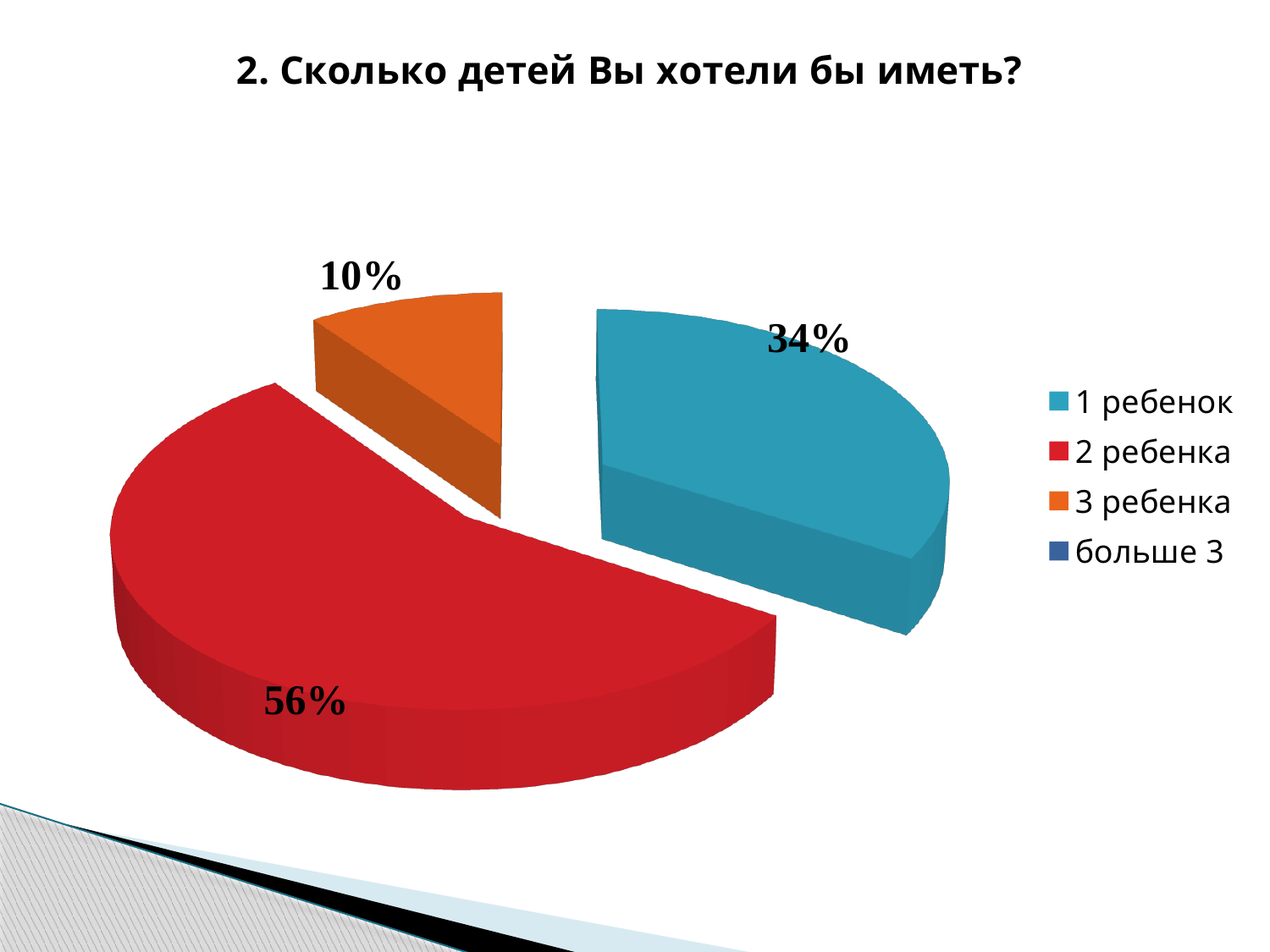
What share of the pie corresponds to "2 ребенка"? 56% What share of the pie corresponds to "3 ребенка"? 10% What kind of chart is shown on the slide? pie chart What colour is the slice for "2 ребенка"? red Which is larger: the slice for "1 ребенок" or the slice for "3 ребенка"? 1 ребенок What is the title of the chart? 2. Сколько детей Вы хотели бы иметь? What is the difference between the share for "1 ребенок" and the share for "3 ребенка"? 24% What is the difference between the share for "2 ребенка" and the share for "1 ребенок"? 22% How many entries does the legend list? 4 What share of the pie corresponds to "1 ребенок"? 34% Which category has the largest slice of the pie? 2 ребенка Which of the visible slices is the smallest? 3 ребенка